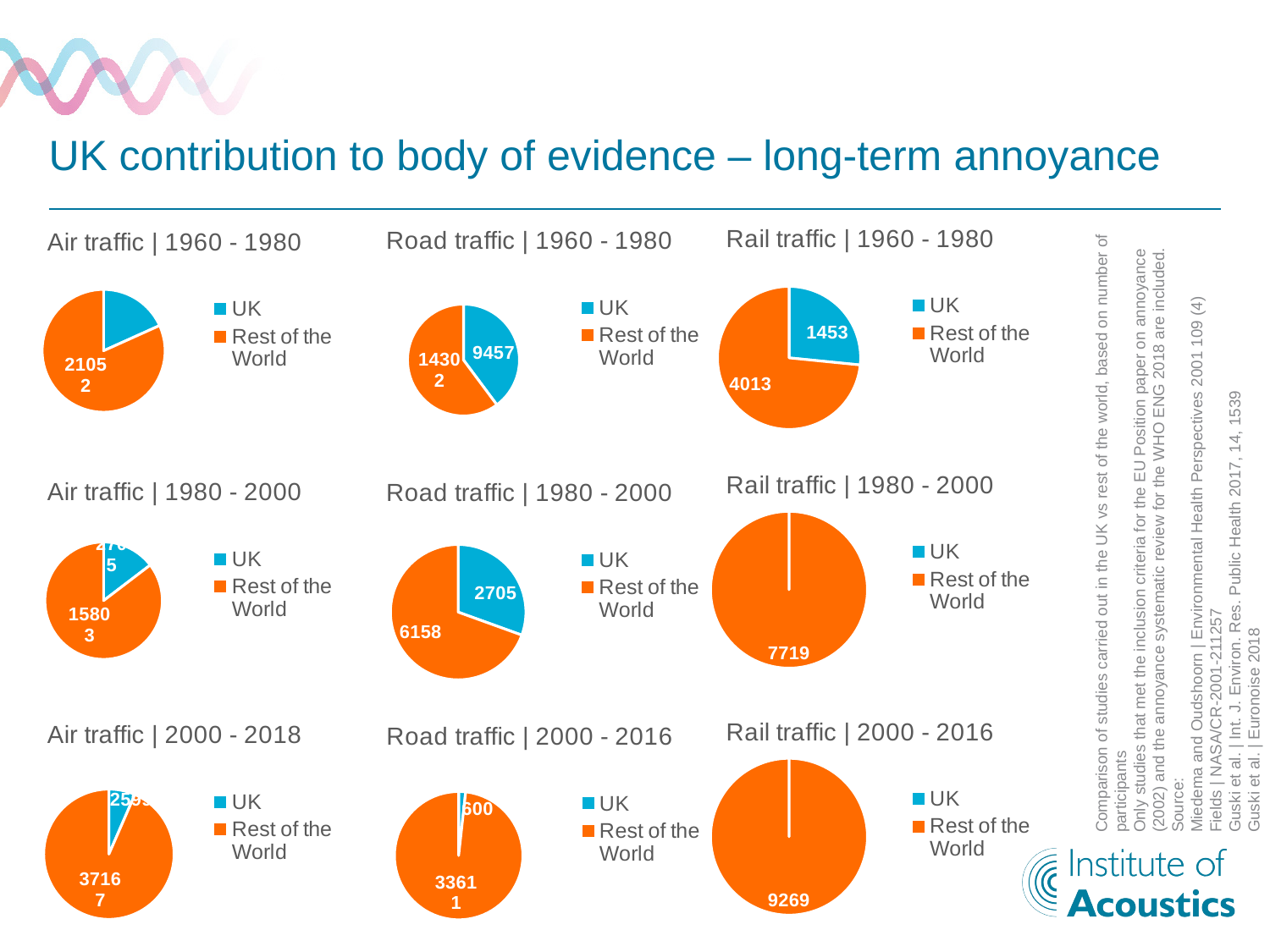
How many entries does the legend of the Road traffic | 2000 - 2016 chart list? 2 In the Road traffic | 1960 - 1980 pie chart, what is the value for UK? 9457 In the Rail traffic | 1960 - 1980 pie chart, what is the difference between the Rest of the World value and the UK value? 2560 In the Rail traffic | 2000 - 2016 pie chart, what is the value for Rest of the World? 9269 In the Rail traffic | 1980 - 2000 pie chart, what is the value for Rest of the World? 7719 In the Rail traffic | 1960 - 1980 pie chart, what is the value for Rest of the World? 4013 In the Road traffic | 1980 - 2000 pie chart, what is the value for UK? 2705 In the Road traffic | 1980 - 2000 pie chart, what is the value for Rest of the World? 6158 What kind of chart is used for Air traffic | 1960 - 1980? Pie chart In the Rail traffic | 1960 - 1980 pie chart, which is larger, UK or Rest of the World? Rest of the World In the Rail traffic | 1960 - 1980 pie chart, what is the value for UK? 1453 In the Road traffic | 1980 - 2000 pie chart, how much larger is the Rest of the World value than the UK value? 3453